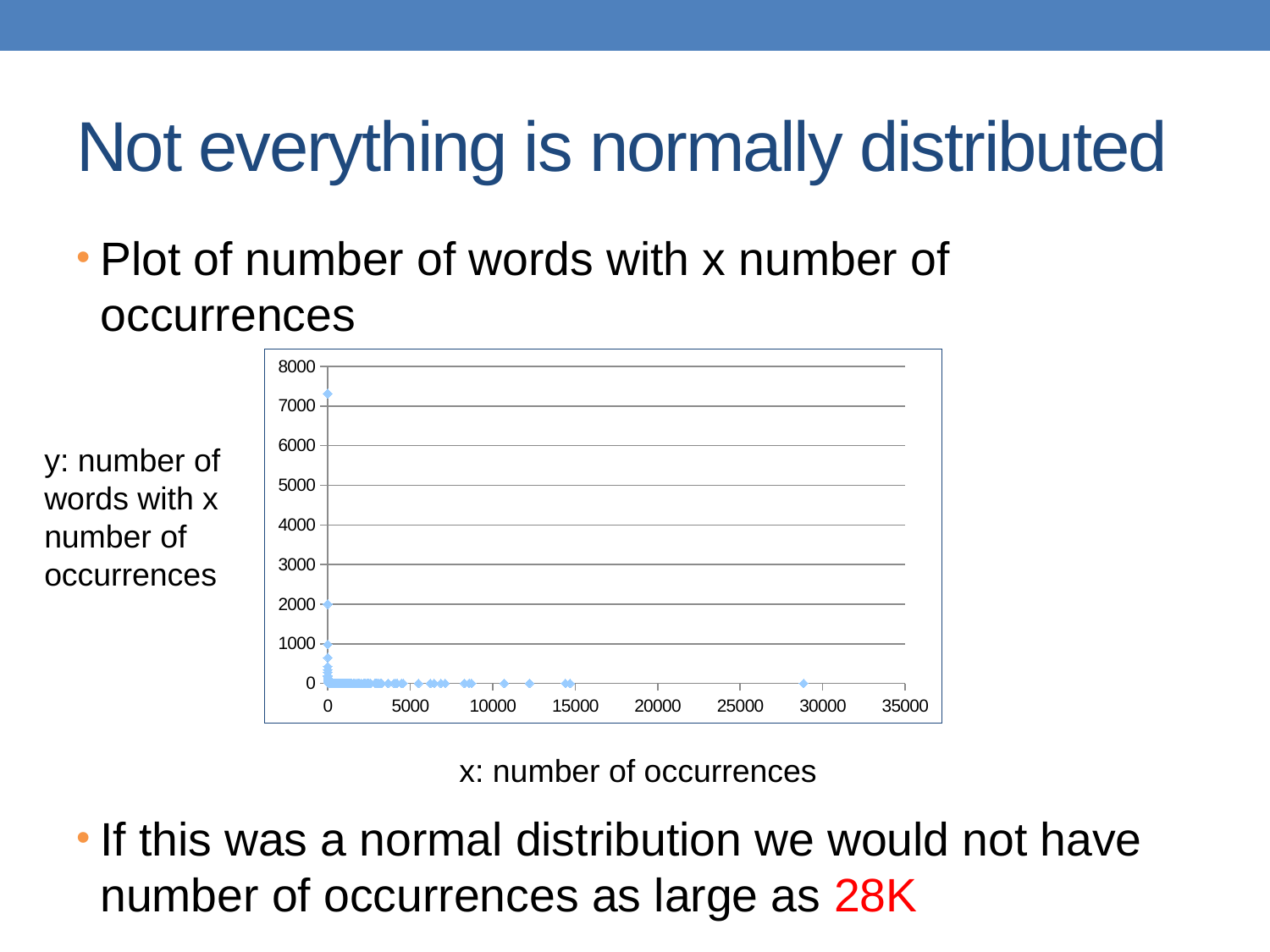
Do the y values generally rise or fall as the number of occurrences on the x axis increases? fall Is the y value of the second-highest point on the chart greater or less than 1000? greater Is the y value of the highest point on the chart greater or less than 7000? greater Is the y value of the second-highest point on the chart greater or less than 3000? less What is the largest value shown on the x axis of the chart? 35000 What is the largest value shown on the y axis of the chart? 8000 What kind of chart is shown on the slide? scatter chart